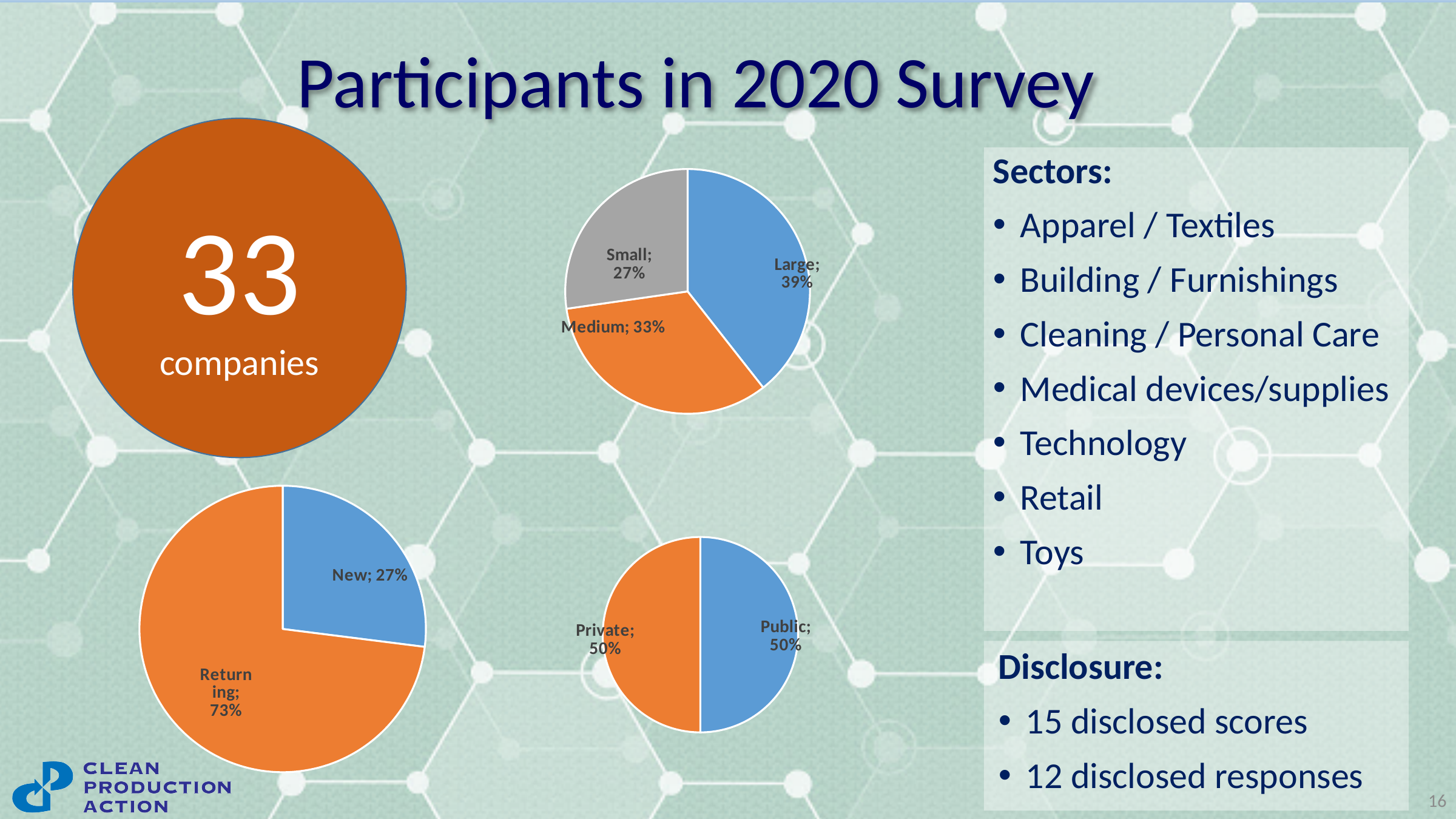
What kind of chart is used for the bottom centre chart showing Public and Private? Pie chart In the pie chart at the bottom left of the slide, which is larger, New or Returning? Returning In the pie chart at the bottom left of the slide, what share is labelled Returning? 73% In the pie chart at the top centre of the slide (company size), which category has the largest slice? Large In the pie chart at the top centre of the slide (company size), which category has the smallest slice? Small In the pie chart at the top centre of the slide (company size), what share is labelled Medium? 33% In the pie chart at the bottom centre of the slide, what share is labelled Private? 50% In the pie chart at the top centre of the slide (company size), how many slices are there? 3 In the pie chart at the top centre of the slide (company size), what share is labelled Large? 39% In the pie chart at the top centre of the slide (company size), what is the difference in percentage points between Large and Small? 12 In the pie chart at the bottom left of the slide, what share is labelled New? 27% In the pie chart at the top centre of the slide (company size), what share is labelled Small? 27%